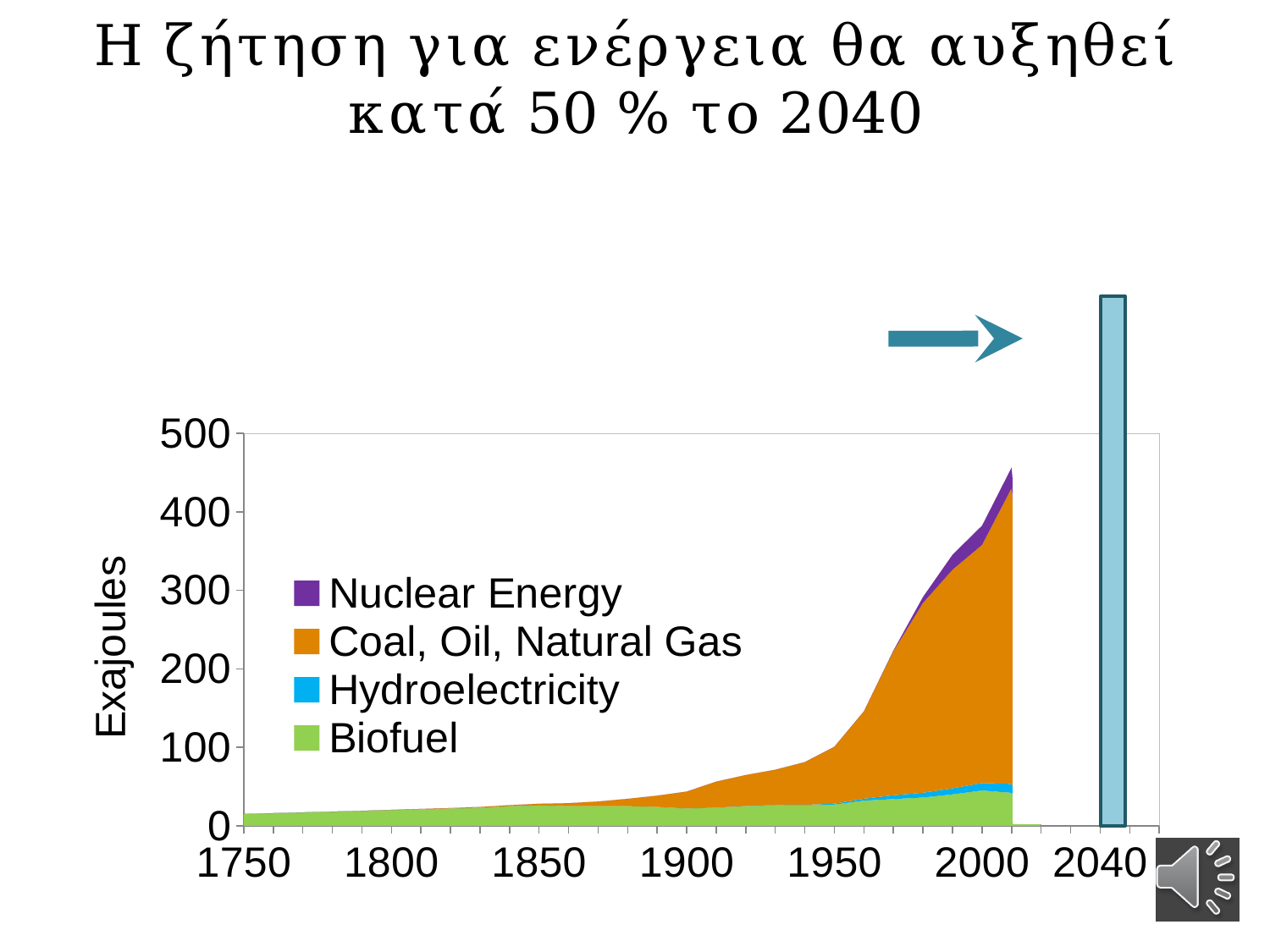
What is the label on the vertical axis of the chart? Exajoules How many series does the chart's legend list? 4 Which series is shown in orange in the chart's legend? Coal, Oil, Natural Gas Which series accounts for the largest share of total energy around the year 2000? Coal, Oil, Natural Gas Is the total energy value in 1900 greater or less than 100 exajoules? less Which series accounts for the smallest share of total energy around the year 2000? Hydroelectricity What kind of chart is shown on the slide? Stacked area chart Does total energy consumption rise or fall from 1750 to 2010 along the x axis? Rise Which is larger around the year 2000: the Coal, Oil, Natural Gas area or the Biofuel area? Coal, Oil, Natural Gas Is the total energy value at the right end of the stacked area (around 2010) greater or less than 400 exajoules? greater What is the highest value shown on the vertical axis of the chart? 500 Is the total energy value in 1950 greater or less than 200 exajoules? less